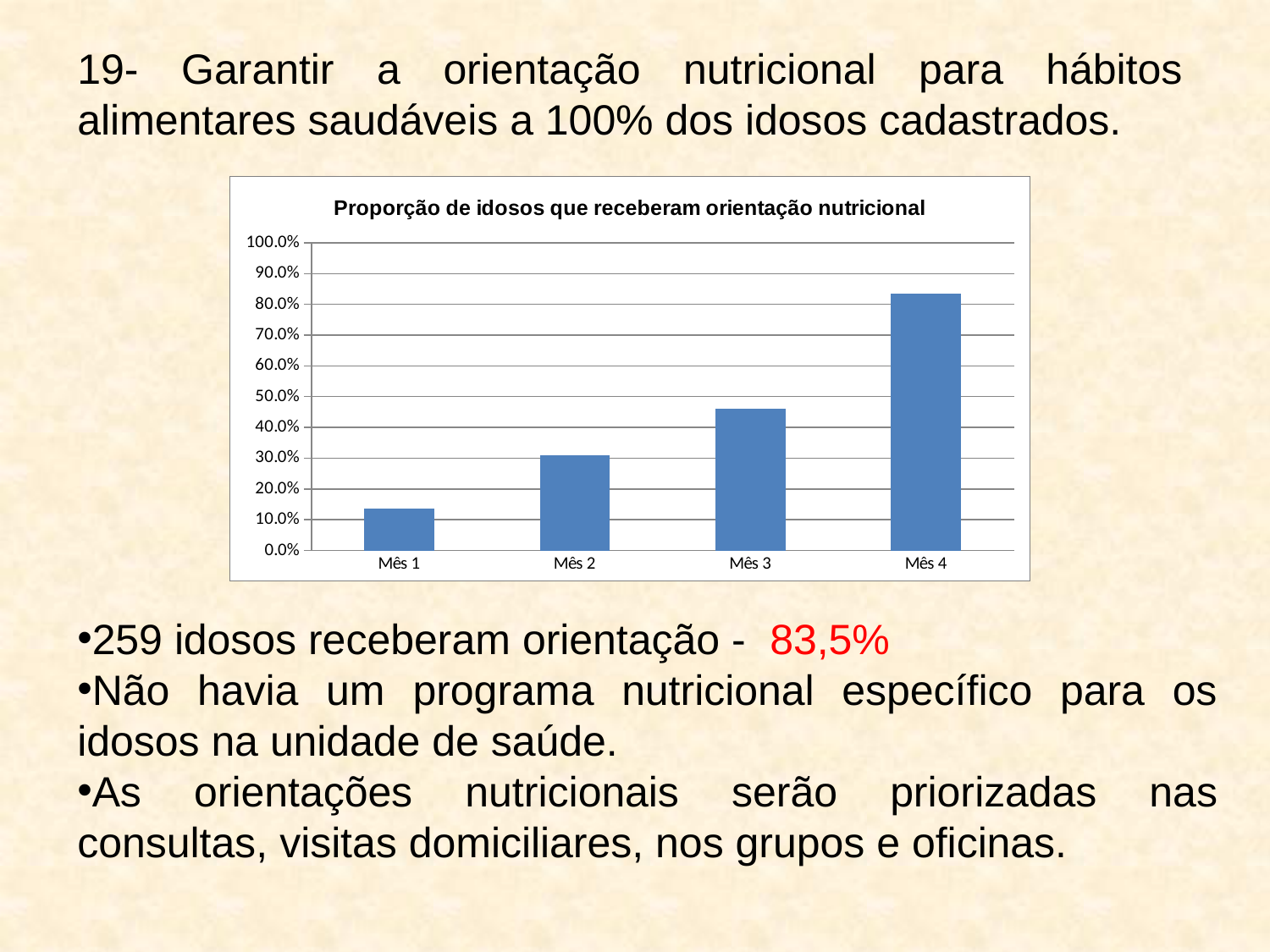
Is the value for Mês 4 greater or less than 70.0%? greater Is the value for Mês 3 greater or less than 50.0%? less What is the maximum value shown on the y axis of the chart? 100.0% Do the values rise or fall from Mês 1 to Mês 4? rise Is the value for Mês 2 greater or less than 20.0%? greater Which is larger, the value for Mês 2 or the value for Mês 3? Mês 3 How many categories (months) are shown on the x axis of the chart? 4 Which month has the highest proportion of elderly who received nutritional guidance? Mês 4 What type of chart is shown on the slide? bar chart What is the title of the chart? Proporção de idosos que receberam orientação nutricional Which month has the lowest proportion of elderly who received nutritional guidance? Mês 1